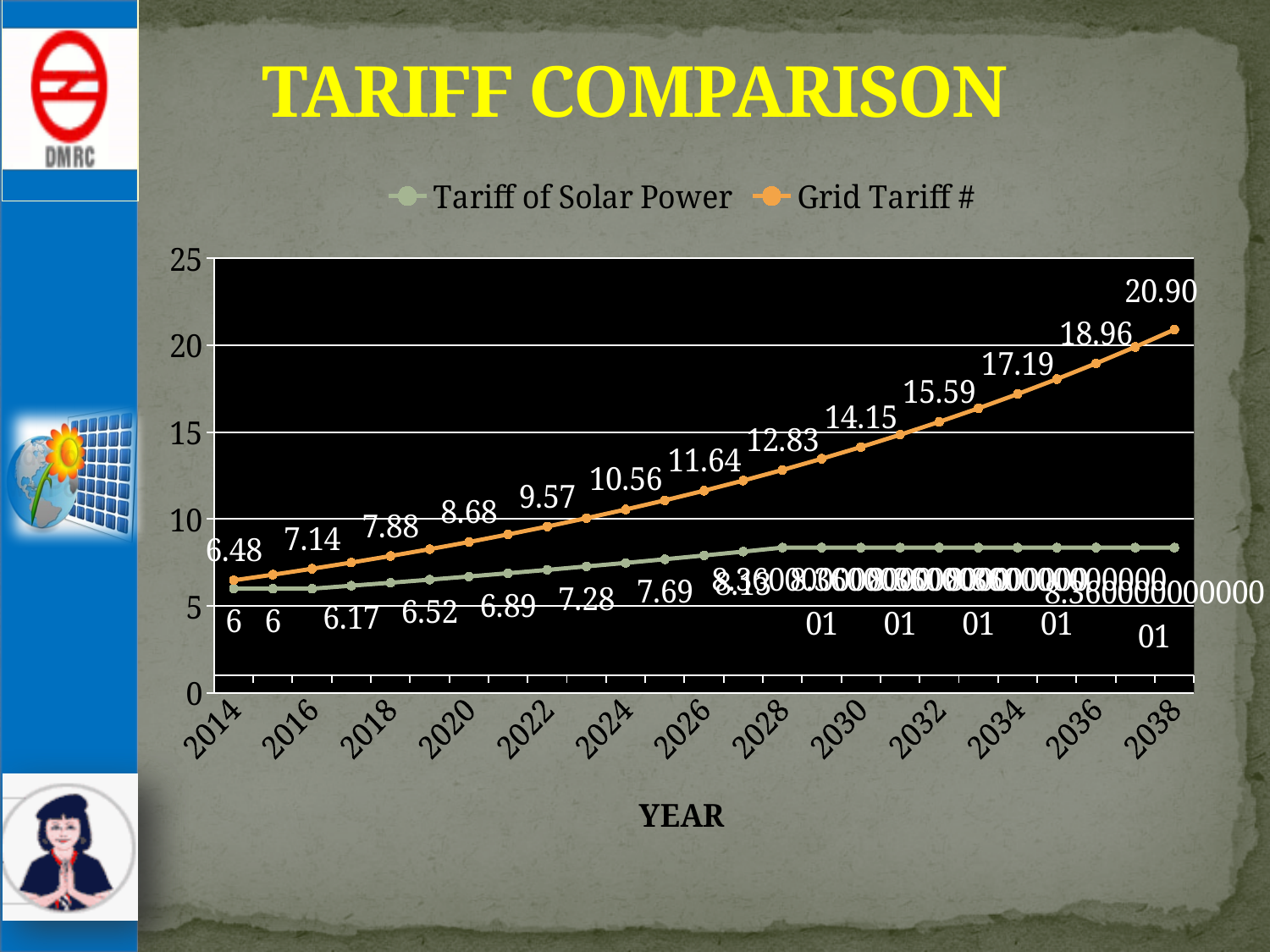
What is the Grid Tariff # value for 2014? 6.48 In which year is the Grid Tariff # highest? 2038 How many series does the legend list? 2 In 2026, which series has the larger value, Tariff of Solar Power or Grid Tariff #? Grid Tariff # What is the Grid Tariff # value for 2030? 14.15 What is the title of the x axis? YEAR What is the Grid Tariff # value for 2038? 20.90 What kind of chart is shown on the slide? line chart By how much does the Grid Tariff # in 2038 exceed the Grid Tariff # in 2014? 14.42 Does the Grid Tariff # rise or fall from 2014 to 2038? rise Is the Tariff of Solar Power value for 2036 greater or less than 10? less